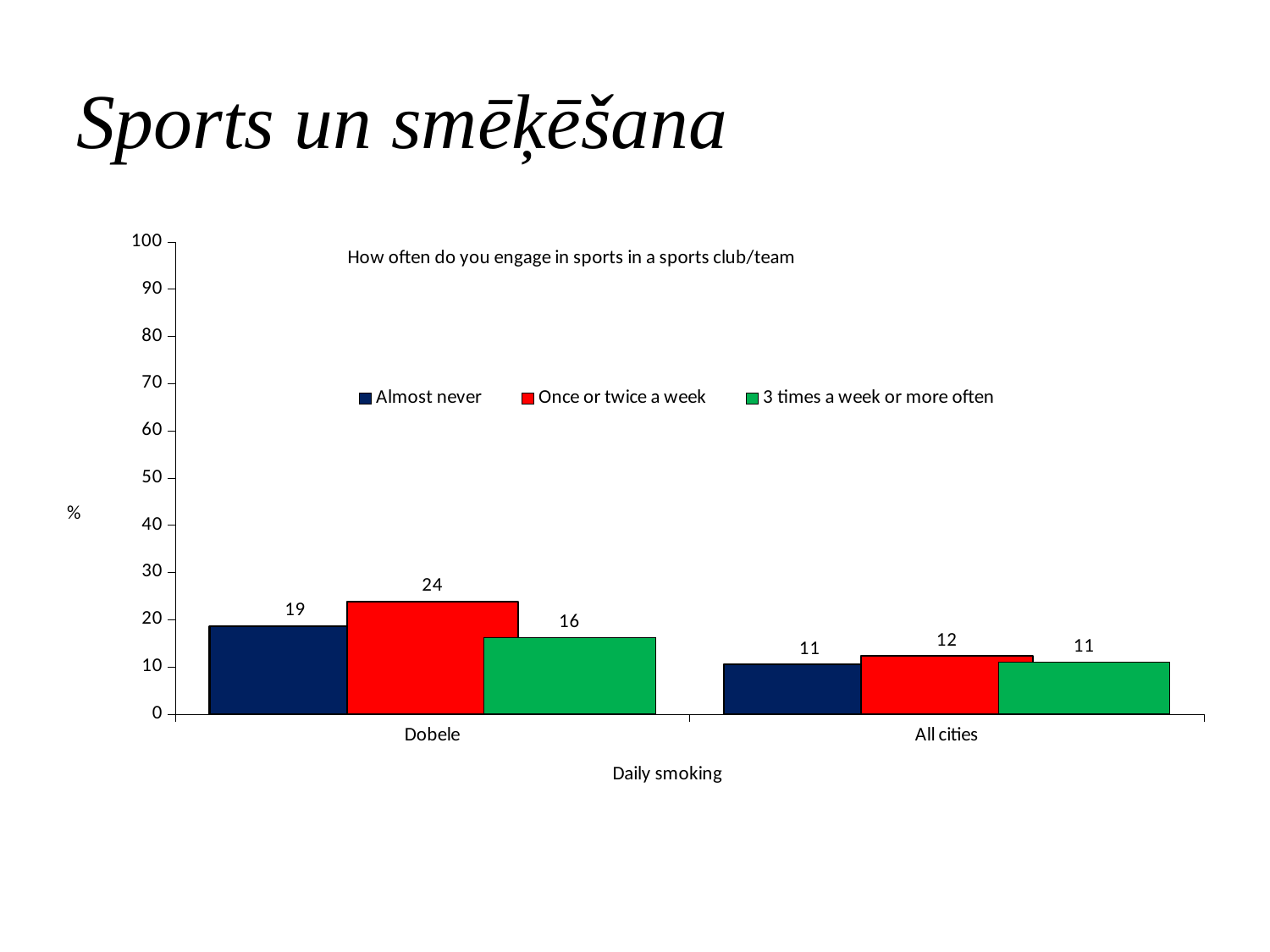
What is the value for 'Once or twice a week' in Dobele? 24 Which series has the lowest value in Dobele? 3 times a week or more often What is the difference between 'Once or twice a week' in Dobele and in All cities? 12 Is the value for 'Once or twice a week' in Dobele greater or less than 20? greater Which is larger: 'Almost never' in Dobele or 'Almost never' in All cities? Dobele What is the x-axis title of the chart? Daily smoking What is the value for '3 times a week or more often' in Dobele? 16 Which series has the highest value in Dobele? Once or twice a week What is the value for 'Almost never' in All cities? 11 How many series does the legend list? 3 What kind of chart is shown on the slide? Bar chart How many categories are shown on the x axis? 2